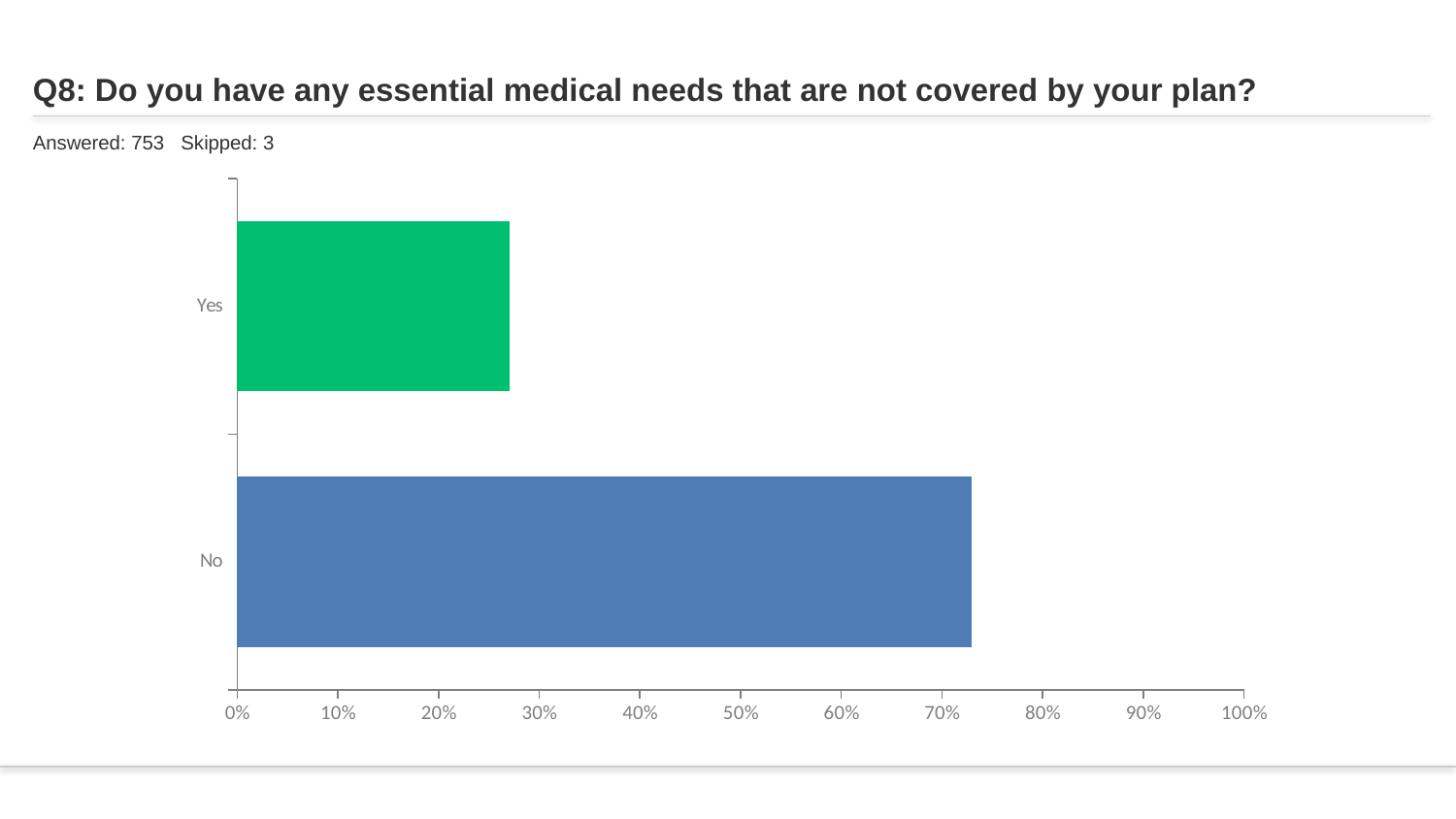
Is the value for No greater or less than 80%? less How many respondents answered the question according to the slide? 753 Is the value for No greater or less than 70%? greater Is the value for Yes greater or less than 20%? greater Which response category has the lowest value? Yes Which is larger, the value for Yes or the value for No? No What kind of chart is shown on the slide? bar chart Which response category has the highest value? No How many response categories are plotted in the chart? 2 What is the highest value shown on the x axis? 100%